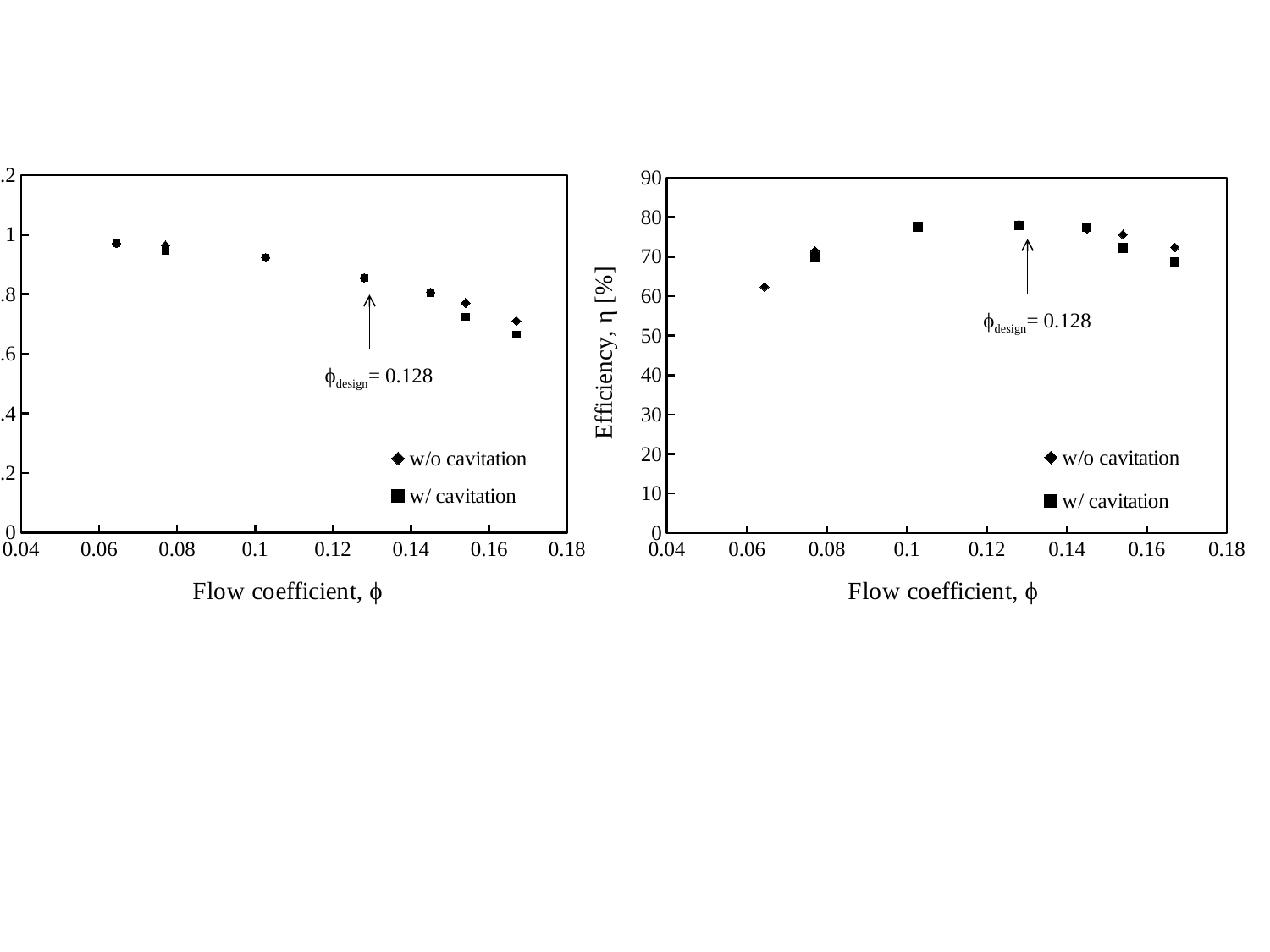
In the right-hand chart, does efficiency rise or fall as the flow coefficient increases from about 0.06 to about 0.10? rise In the right-hand chart, is the w/ cavitation efficiency at a flow coefficient of about 0.10 greater or less than 70? greater What is the y-axis title of the right-hand chart? Efficiency, η [%] In the right-hand chart, is the w/ cavitation efficiency at a flow coefficient of about 0.167 greater or less than 80? less What kind of chart is the right-hand chart (Efficiency vs Flow coefficient)? scatter chart In the right-hand chart, is the w/o cavitation efficiency at a flow coefficient of about 0.064 greater or less than 50? greater In the right-hand chart, at a flow coefficient of about 0.154, which series has the higher efficiency: w/o cavitation or w/ cavitation? w/o cavitation What are the two legend entries on the left-hand chart? w/o cavitation and w/ cavitation In the left-hand chart, at a flow coefficient of about 0.167, which series has the higher value: w/o cavitation or w/ cavitation? w/o cavitation In the right-hand chart, at a flow coefficient of about 0.167, which series has the higher efficiency: w/o cavitation or w/ cavitation? w/o cavitation How many series does the legend of the right-hand chart list? 2 In the left-hand chart, do the plotted values rise or fall as the flow coefficient increases from 0.06 to 0.17? fall